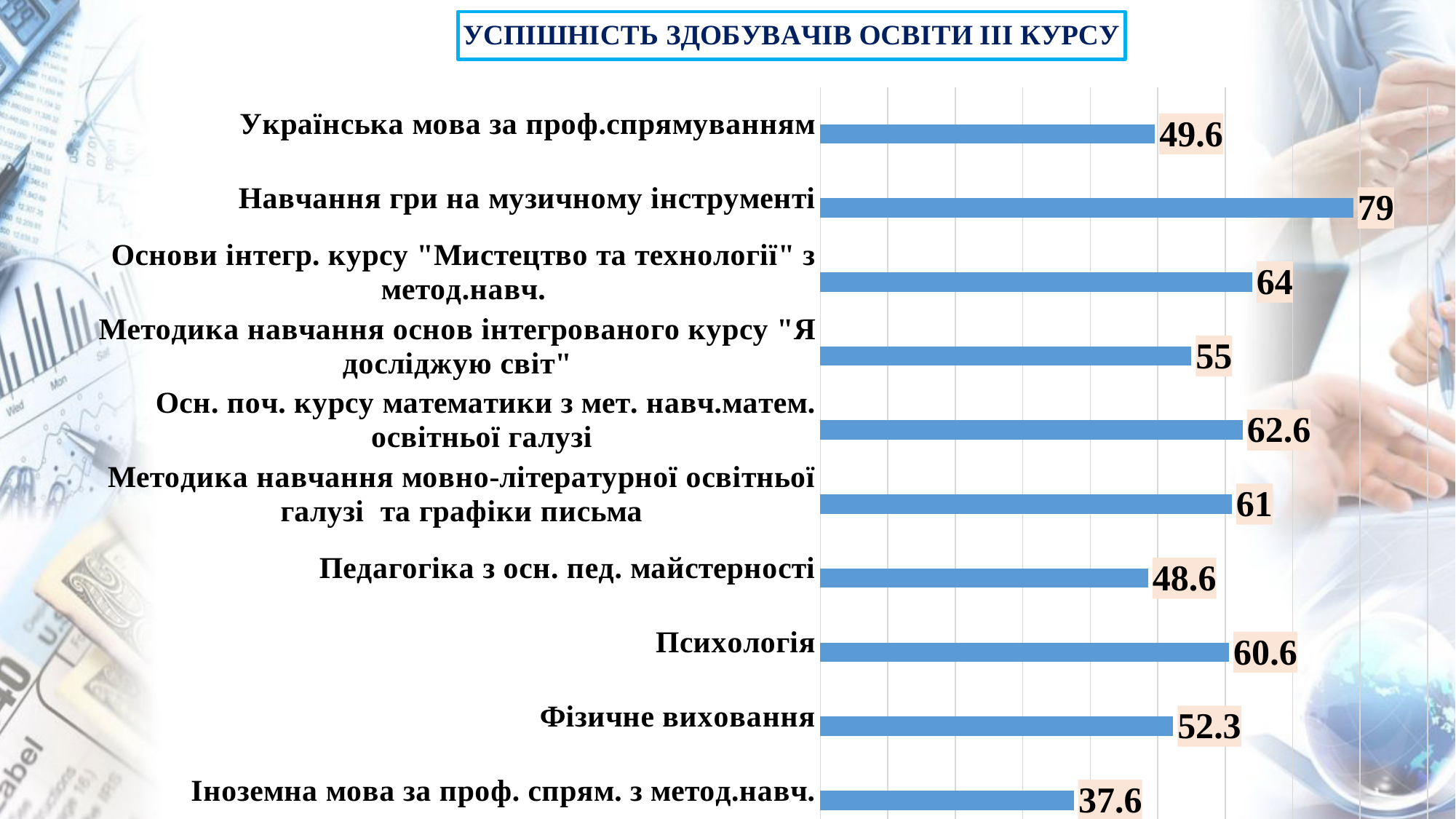
What is the difference between the value for Основи інтегр. курсу "Мистецтво та технології" з метод.навч. and the value for Методика навчання основ інтегрованого курсу "Я досліджую світ"? 9 How many categories are shown in the chart? 10 Which is larger: the value for Українська мова за проф.спрямуванням or the value for Фізичне виховання? Фізичне виховання What is the value for Фізичне виховання? 52.3 What is the title of the slide? УСПІШНІСТЬ ЗДОБУВАЧІВ ОСВІТИ ІІІ КУРСУ What is the value for Психологія? 60.6 What is the value for Навчання гри на музичному інструменті? 79 What is the difference between the highest value (Навчання гри на музичному інструменті) and the lowest value (Іноземна мова за проф. спрям. з метод.навч.)? 41.4 Which category has the lowest value? Іноземна мова за проф. спрям. з метод.навч. What is the value for Педагогіка з осн. пед. майстерності? 48.6 Which category has the highest value? Навчання гри на музичному інструменті What kind of chart is shown on the slide? Bar chart